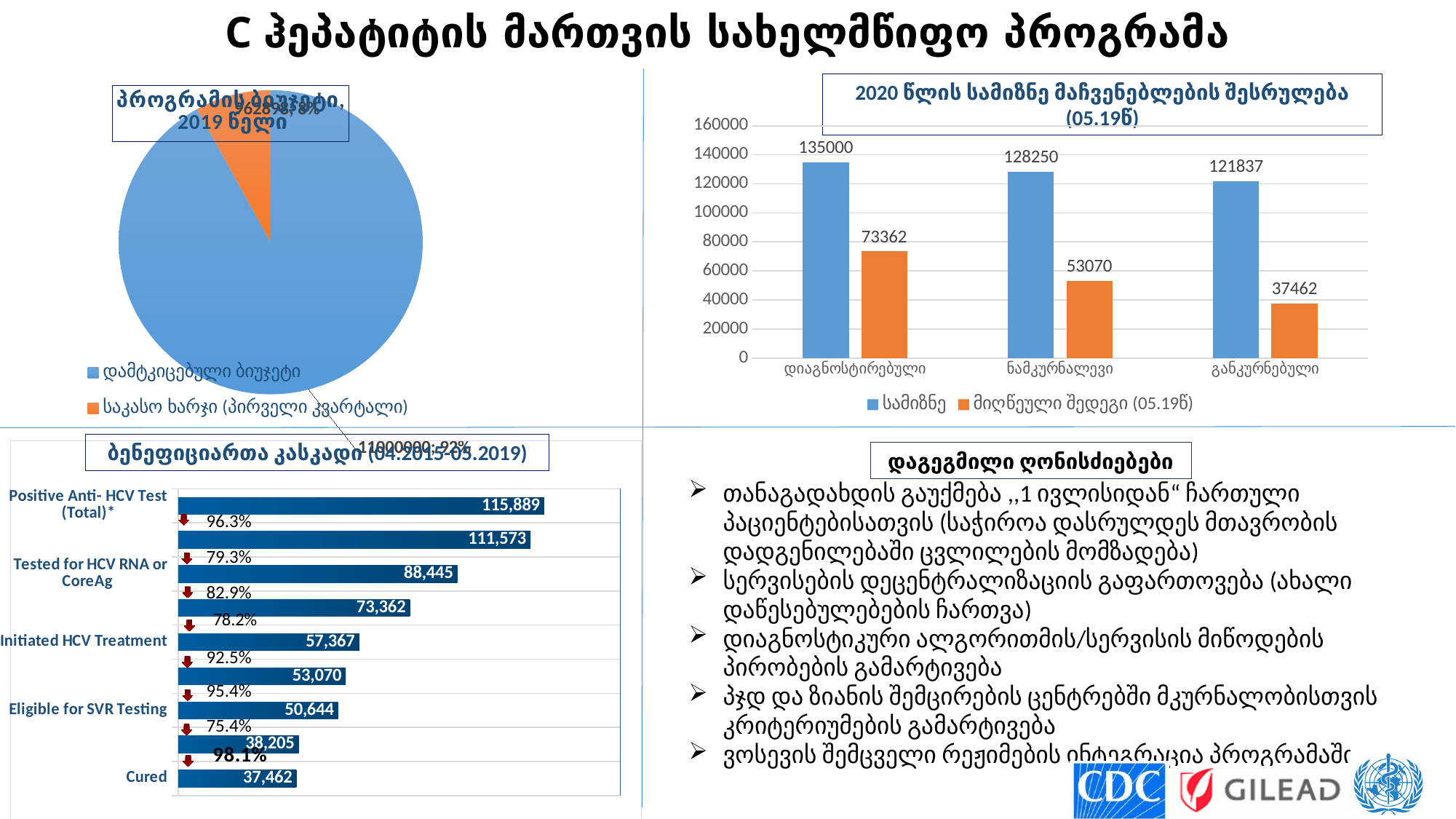
In the top-right bar chart, what is the achieved result (მიღწეული შედეგი) for ნამკურნალევი? 53070 What kind of chart is the top-left chart titled პროგრამის ბიუჯეტი, 2019 წელი? pie chart In the top-right bar chart, how many categories are shown on the x axis? 3 In the top-right bar chart, what is the target (სამიზნე) value for დიაგნოსტირებული? 135000 In the top-right bar chart, what is the achieved result (მიღწეული შედეგი) for განკურნებული? 37462 In the top-right bar chart, what is the difference between the target and the achieved result for დიაგნოსტირებული? 61638 In the bottom-left cascade chart, do the bar values rise or fall from the top bar to the bottom bar? fall In the top-right bar chart, is the target value for განკურნებული greater or less than 100000? greater In the top-left pie chart, what share does the დამტკიცებული ბიუჯეტი slice represent? 92% In the top-right bar chart, which category has the lowest achieved result (მიღწეული შედეგი)? განკურნებული In the top-right bar chart, how many series does the legend list? 2 In the bottom-left cascade chart, what is the value of the Cured bar? 37,462